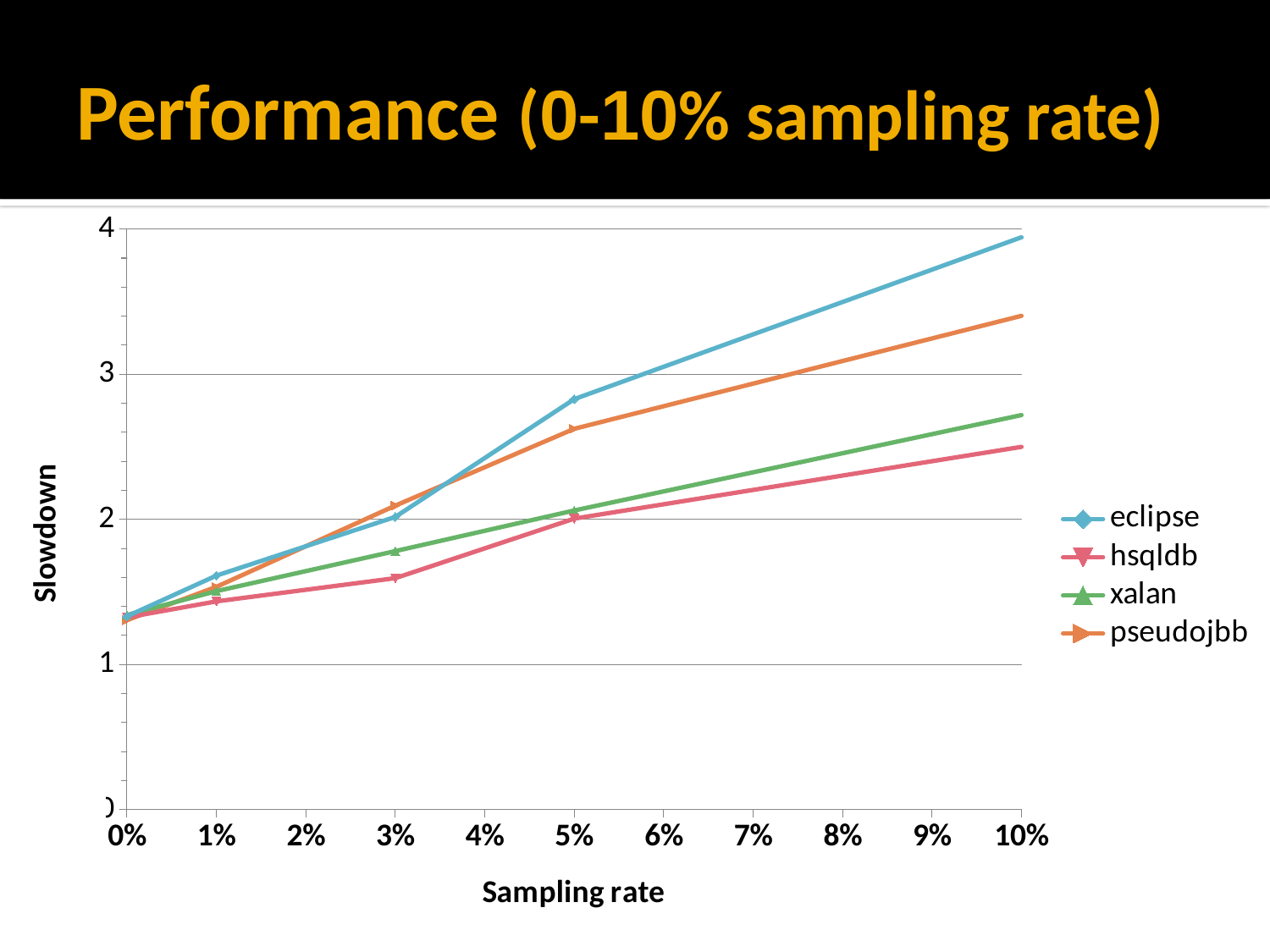
Is the slowdown for xalan at 10% sampling rate greater or less than 3? less Which series has the lowest slowdown at a 10% sampling rate? hsqldb Is the slowdown for eclipse at 5% sampling rate greater or less than 3? less What is the title of the slide containing the chart? Performance (0-10% sampling rate) At a 5% sampling rate, which has the larger slowdown, eclipse or hsqldb? eclipse What kind of chart is shown on the slide? line chart Is the slowdown for eclipse at 10% sampling rate greater or less than 3? greater How many series does the legend list? 4 What is the label of the vertical axis? Slowdown Does the slowdown for pseudojbb rise or fall as the sampling rate increases? rise Which series has the highest slowdown at a 10% sampling rate? eclipse